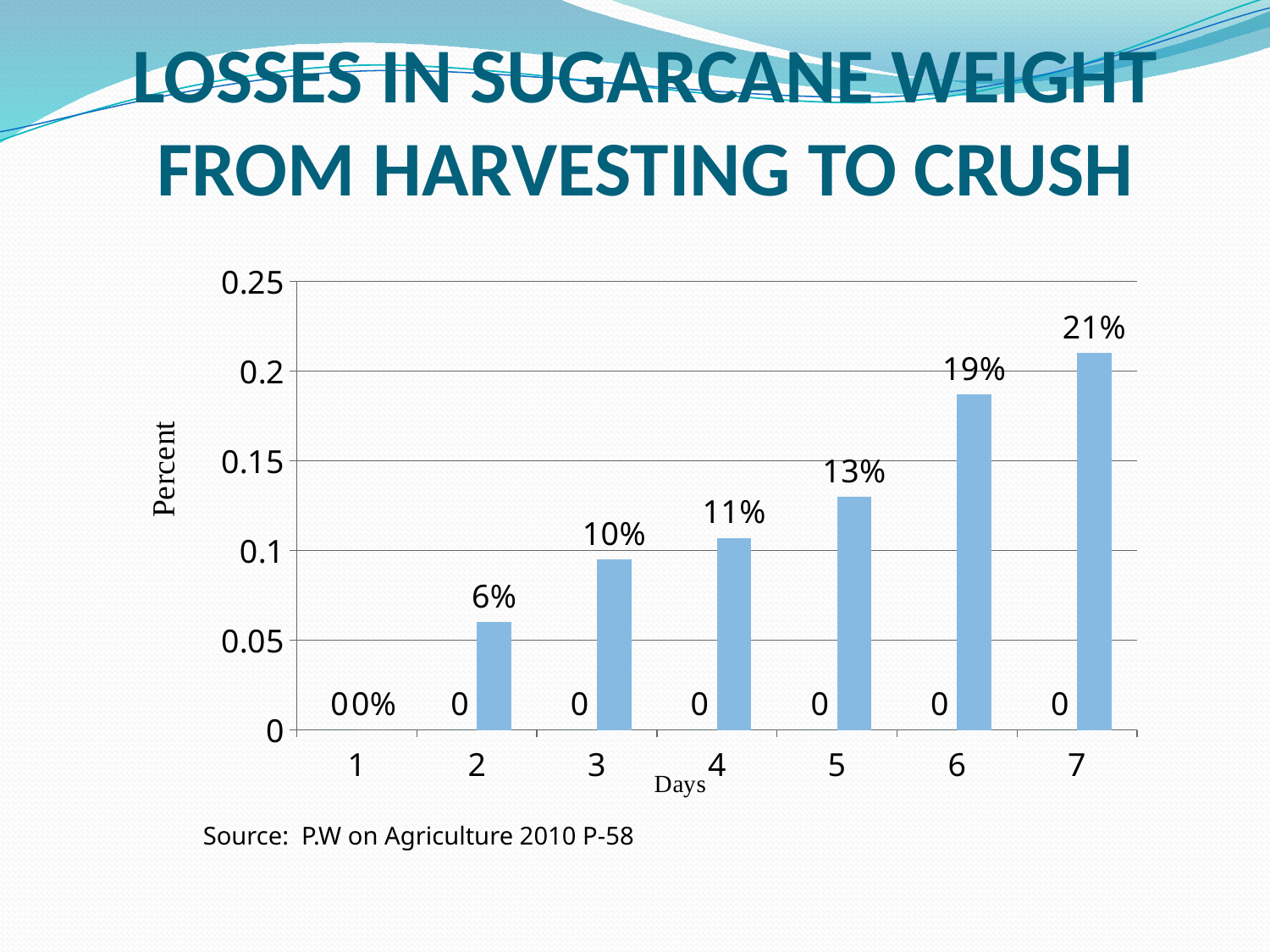
Which day shows the highest loss in sugarcane weight? 7 What kind of chart is shown on the slide? bar chart Do the losses in sugarcane weight rise or fall as the number of days increases? rise What is the loss in sugarcane weight on day 5? 13% What is the difference between the loss on day 7 and the loss on day 6? 2% How many days are shown on the x axis of the chart? 7 Which is larger, the loss on day 3 or the loss on day 6? day 6 What is the difference between the loss on day 5 and the loss on day 2? 7% What is the loss in sugarcane weight on day 2? 6% Which day shows the lowest loss in sugarcane weight? 1 What is the loss in sugarcane weight on day 7? 21% What is the loss in sugarcane weight on day 4? 11%